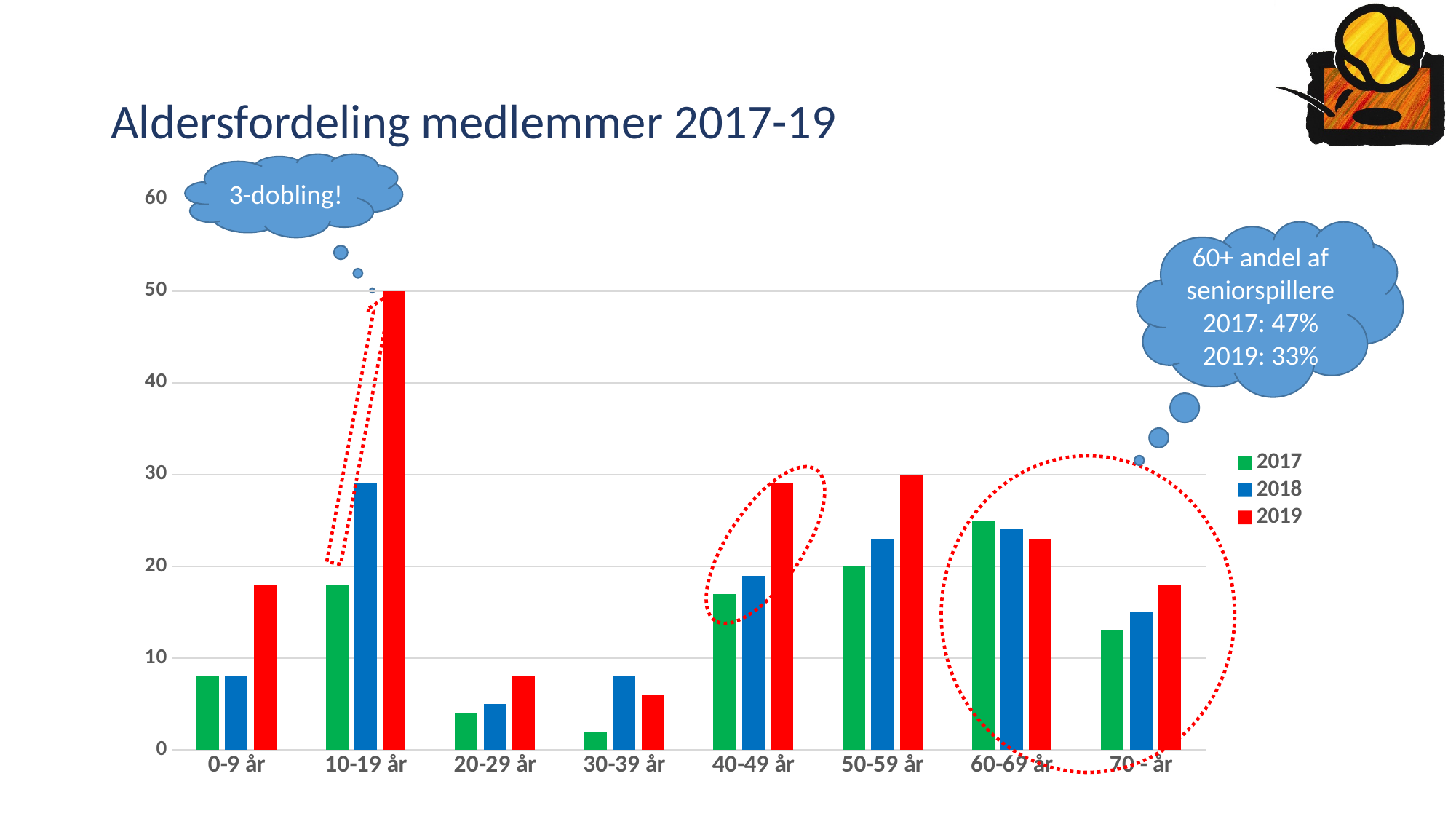
What is the 2017 value for the 50-59 år age group? 20 Which age group has the lowest 2017 value? 30-39 år What kind of chart is shown on the slide? bar chart What is the 2019 value for the 10-19 år age group? 50 Is the 2017 value for 60-69 år greater or less than 20? greater How many series does the legend list? 3 What is the difference between the 2019 and 2017 values for the 50-59 år age group? 10 How many age groups are shown on the x axis? 8 What is the 2019 value for the 50-59 år age group? 30 For the 40-49 år age group, which series has the larger value, 2017 or 2019? 2019 Is the 2018 value for 20-29 år greater or less than 10? less Which age group has the highest 2019 value? 10-19 år